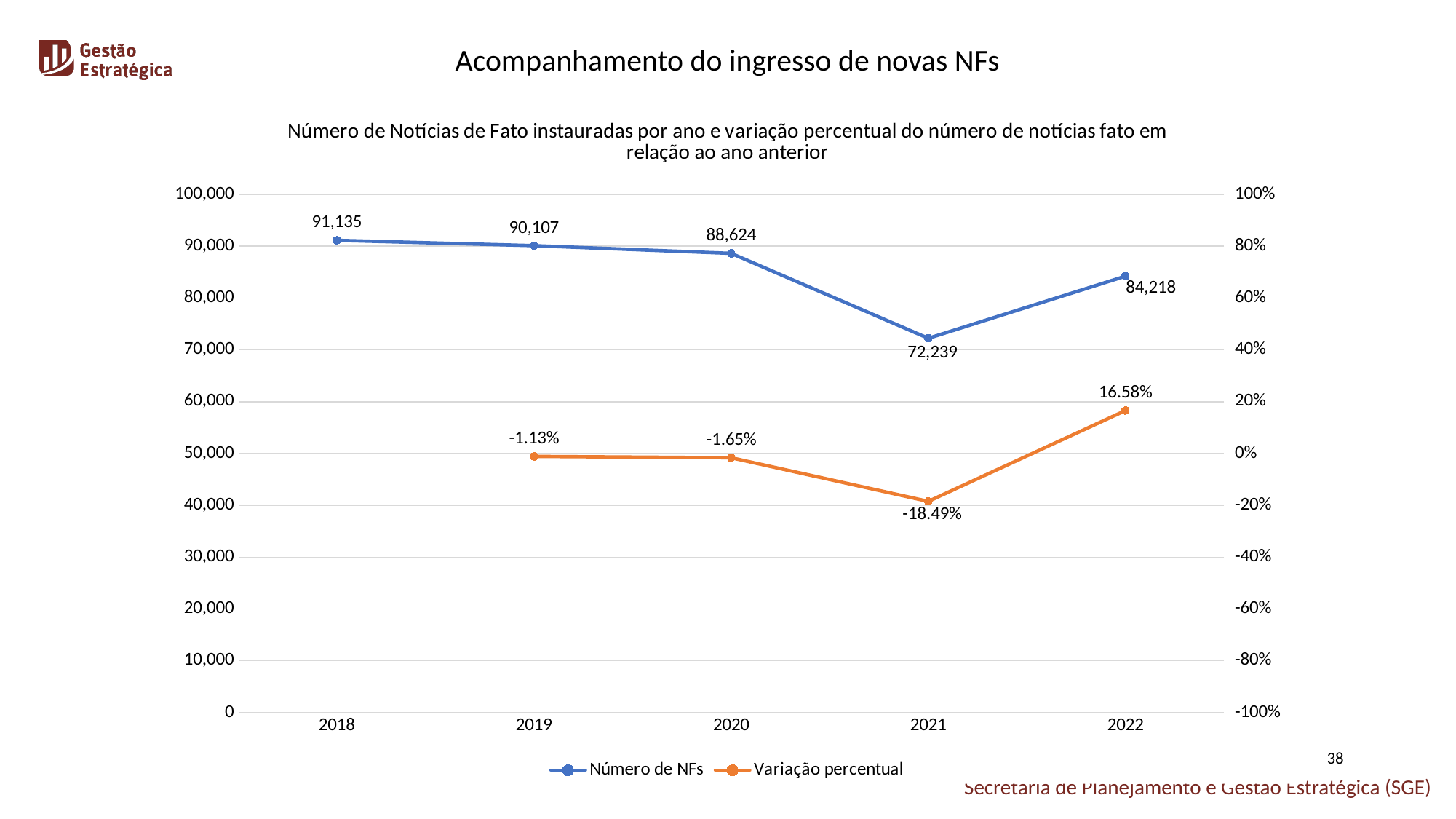
What is the difference in Número de NFs between 2018 and 2021? 18,896 Does the Número de NFs rise or fall from 2018 to 2020? Fall Which year has the lowest Variação percentual? 2021 What is the Variação percentual for 2022? 16.58% Which year has the highest Número de NFs? 2018 What is the Variação percentual for 2019? -1.13% How many series does the legend list? 2 How many years are shown on the x axis? 5 Which is larger, the Número de NFs for 2020 or for 2022? 2020 What is the value of Número de NFs for 2018? 91,135 What is the value of Número de NFs for 2021? 72,239 What kind of chart is shown on the slide? Line chart